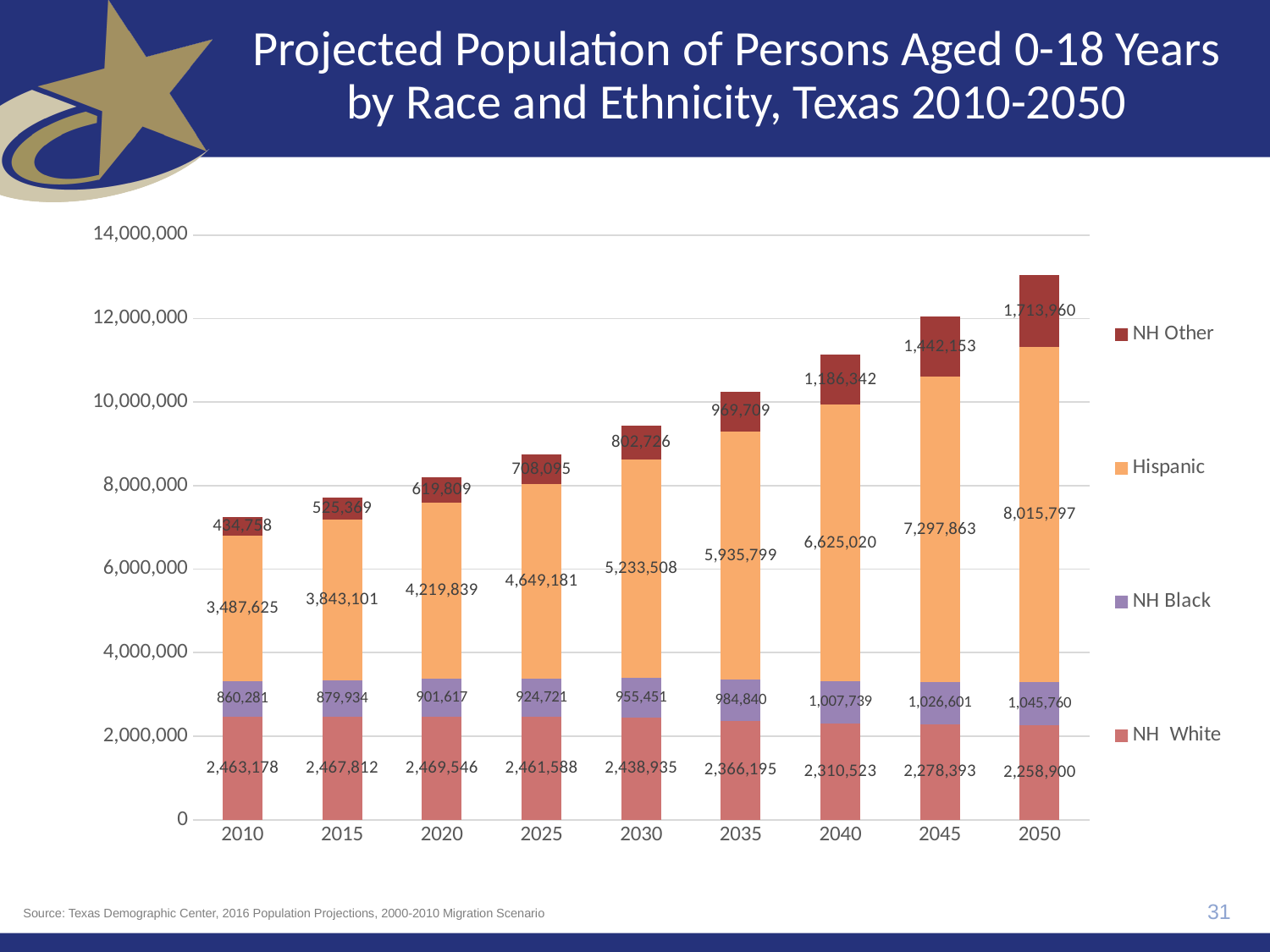
In 2040, which is larger: the projected NH White population or the projected NH Black population aged 0-18? NH White How many years are shown on the x axis of the chart? 9 How many race/ethnicity groups does the legend list? 4 In which year is the projected Hispanic population aged 0-18 the highest? 2050 Does the projected Hispanic population aged 0-18 rise or fall from 2010 to 2050? Rise What is the projected Hispanic population aged 0-18 in 2030? 5,233,508 Is the total projected population aged 0-18 in 2050 greater or less than 12,000,000? greater In which year is the projected NH White population aged 0-18 the lowest? 2050 By how much does the projected Hispanic population aged 0-18 increase from 2010 to 2050? 4,528,172 What kind of chart is shown on the slide? Stacked bar chart What is the projected NH Black population aged 0-18 in 2050? 1,045,760 What is the projected NH White population aged 0-18 in 2010? 2,463,178